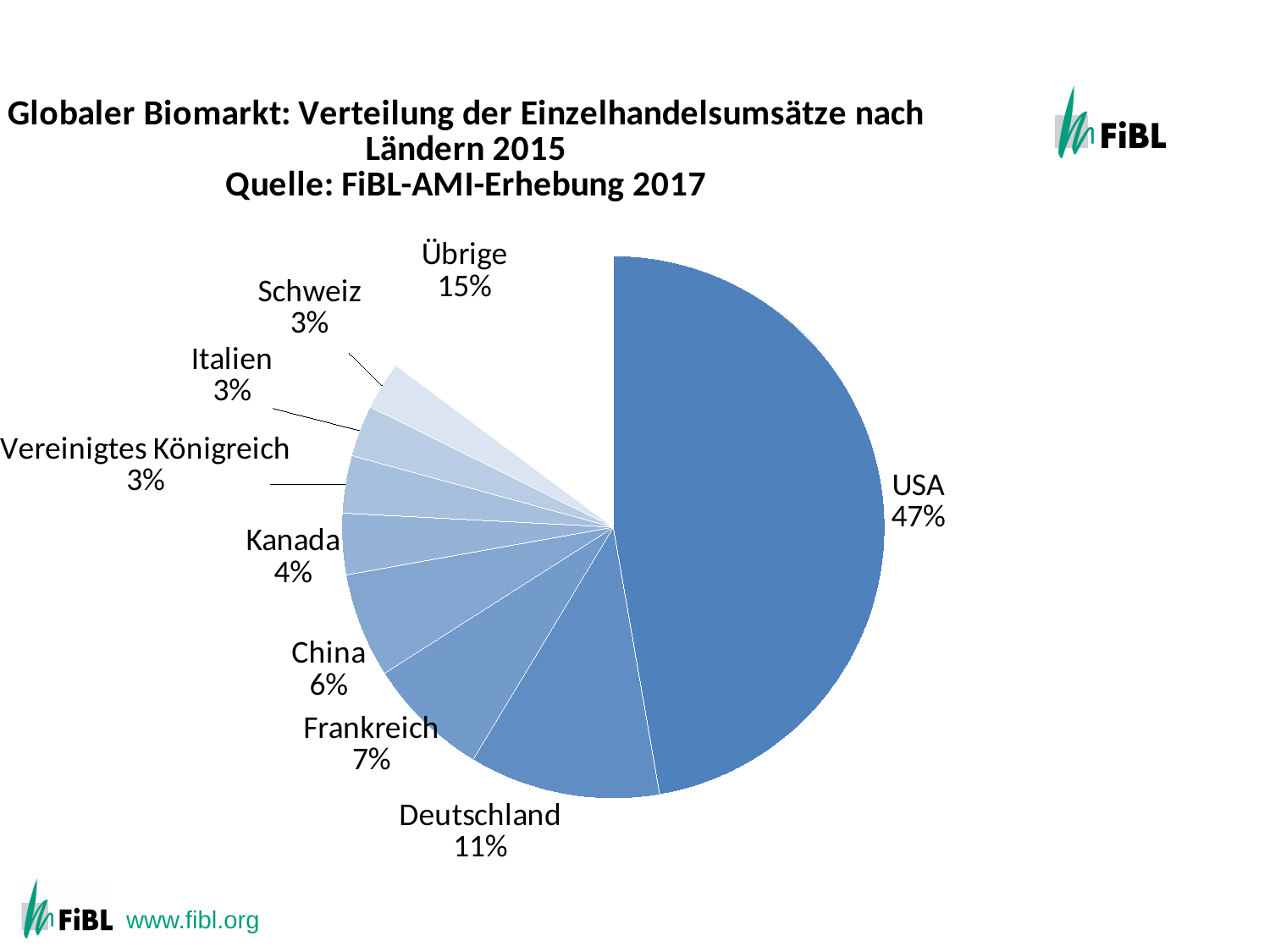
How many slices does the pie chart have? 9 What is the difference between the shares of USA and Deutschland? 36% What is the value shown for Frankreich? 7% What kind of chart is shown on the slide? pie chart What is the value shown for Kanada? 4% What is the title of the chart? Globaler Biomarkt: Verteilung der Einzelhandelsumsätze nach Ländern 2015 Quelle: FiBL-AMI-Erhebung 2017 What share of the pie does USA have? 47% Which is larger, the share for Frankreich or the share for China? Frankreich What share of the pie does Deutschland have? 11% What is the value shown for Übrige? 15% Which category has the largest slice of the pie? USA What is the value shown for China? 6%